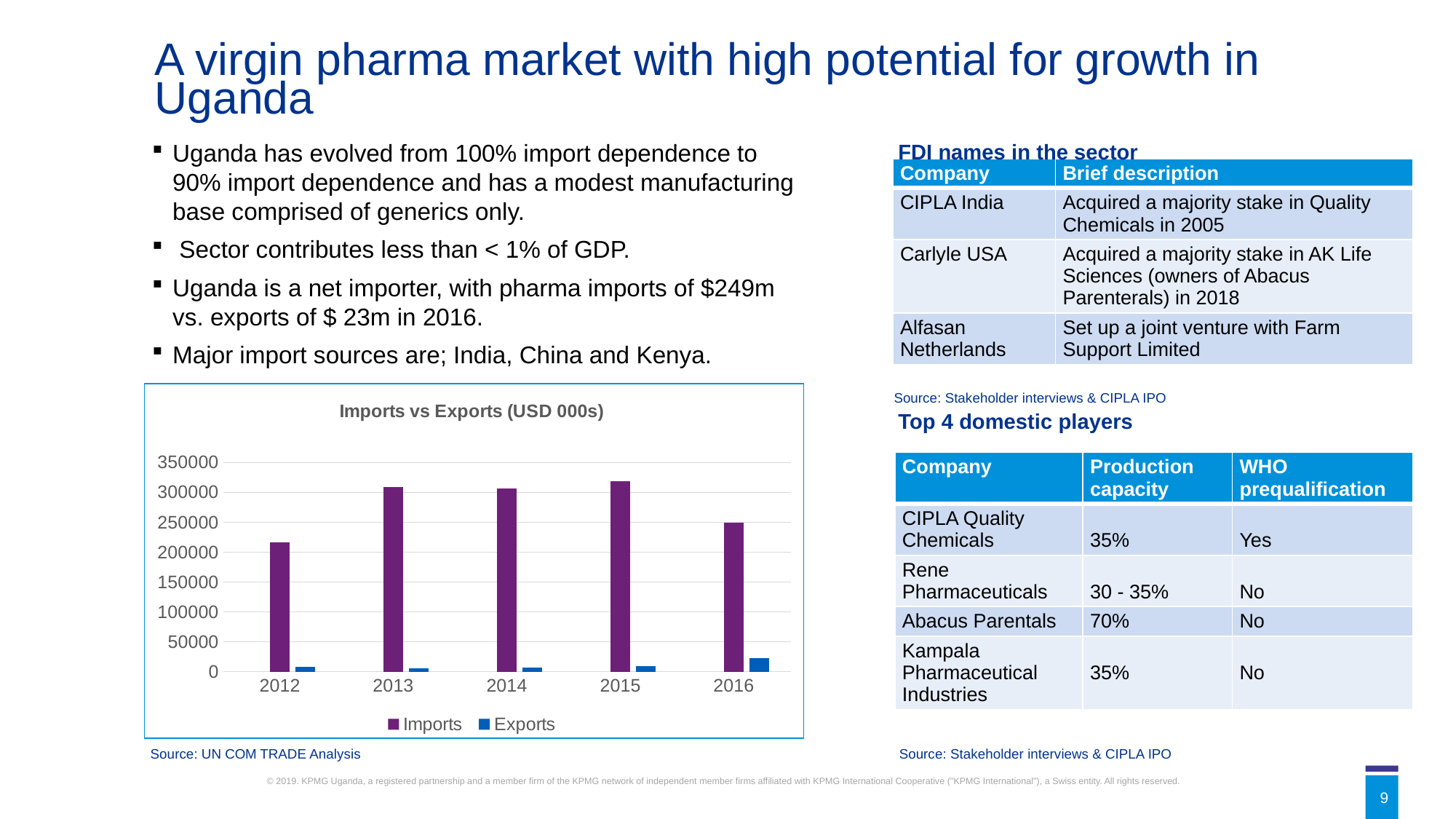
What type of chart is shown on the slide? bar chart Which is larger, the Imports value for 2016 or the Imports value for 2012? 2016 Do Imports rise or fall from 2015 to 2016? fall How many series does the chart legend list? 2 Is the Imports value for 2012 greater or less than 200000? greater Is the Imports value for 2016 greater or less than 300000? less Which year has the lowest Imports value in the chart? 2012 What is the title of the chart? Imports vs Exports (USD 000s) Is the Imports value for 2015 greater or less than 300000? greater How many years are shown on the x axis of the chart? 5 Which year has the highest Exports value in the chart? 2016